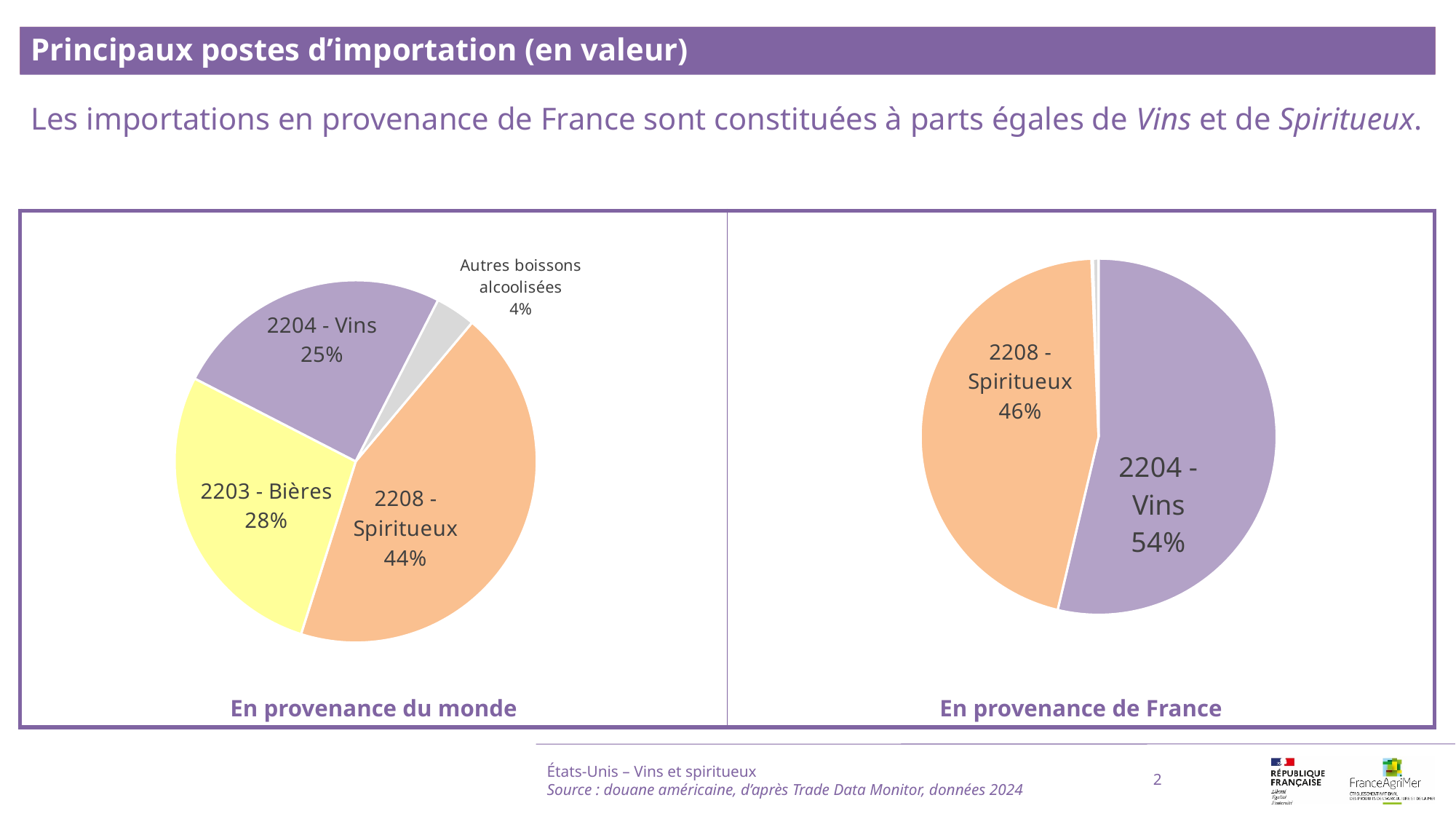
In the 'En provenance de France' chart, what share do 2208 - Spiritueux represent? 46% In the 'En provenance de France' chart, what share do 2204 - Vins represent? 54% In the 'En provenance du monde' chart, what share do 2204 - Vins represent? 25% In the 'En provenance du monde' chart, what share do 2203 - Bières represent? 28% In the 'En provenance du monde' chart, which category has the largest share? 2208 - Spiritueux What type of chart is used on this slide? Pie chart In the 'En provenance du monde' chart, what share do 2208 - Spiritueux represent? 44% In the 'En provenance du monde' chart, how many slices does the pie have? 4 In the 'En provenance du monde' chart, which category has the smallest share? Autres boissons alcoolisées In the 'En provenance du monde' chart, what share do Autres boissons alcoolisées represent? 4% In the 'En provenance de France' chart, what is the difference in percentage points between 2204 - Vins and 2208 - Spiritueux? 8 percentage points In the 'En provenance du monde' chart, which is larger: the share of 2203 - Bières or the share of 2204 - Vins? 2203 - Bières